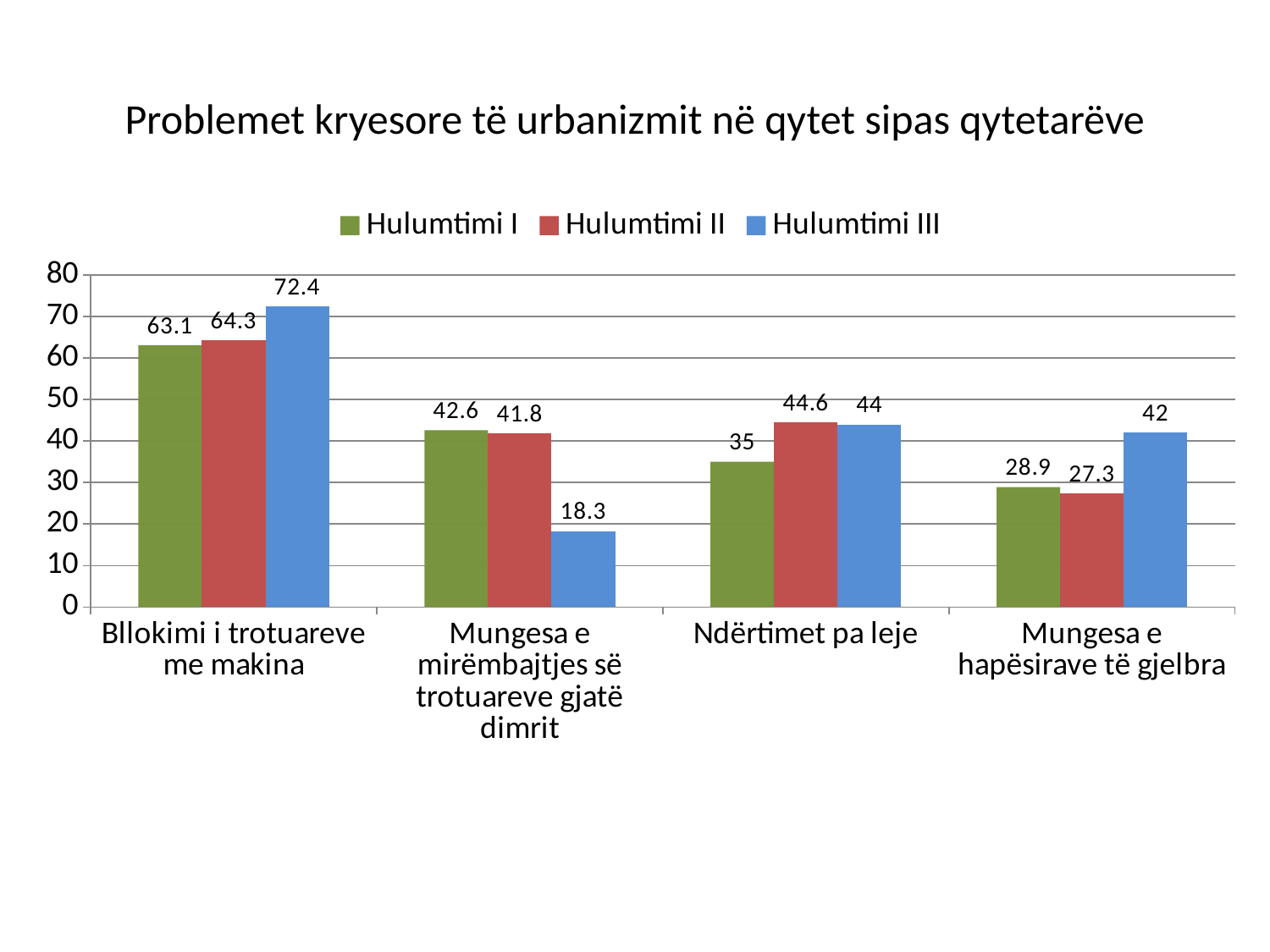
Which category has the lowest value for Hulumtimi III? Mungesa e mirëmbajtjes së trotuareve gjatë dimrit Which category has the highest value for Hulumtimi III? Bllokimi i trotuareve me makina What kind of chart is shown on the slide? bar chart How many series does the legend list? 3 What is the difference between Hulumtimi III and Hulumtimi I in the category 'Bllokimi i trotuareve me makina'? 9.3 What is the value for Hulumtimi II in the category 'Mungesa e hapësirave të gjelbra'? 27.3 How many categories are shown on the x axis? 4 What is the value for Hulumtimi III in the category 'Bllokimi i trotuareve me makina'? 72.4 What is the title of the chart? Problemet kryesore të urbanizmit në qytet sipas qytetarëve What is the value for Hulumtimi I in the category 'Ndërtimet pa leje'? 35 Is the value for Hulumtimi III in 'Mungesa e mirëmbajtjes së trotuareve gjatë dimrit' greater or less than 20? less Which is larger in the category 'Mungesa e hapësirave të gjelbra': Hulumtimi I or Hulumtimi III? Hulumtimi III